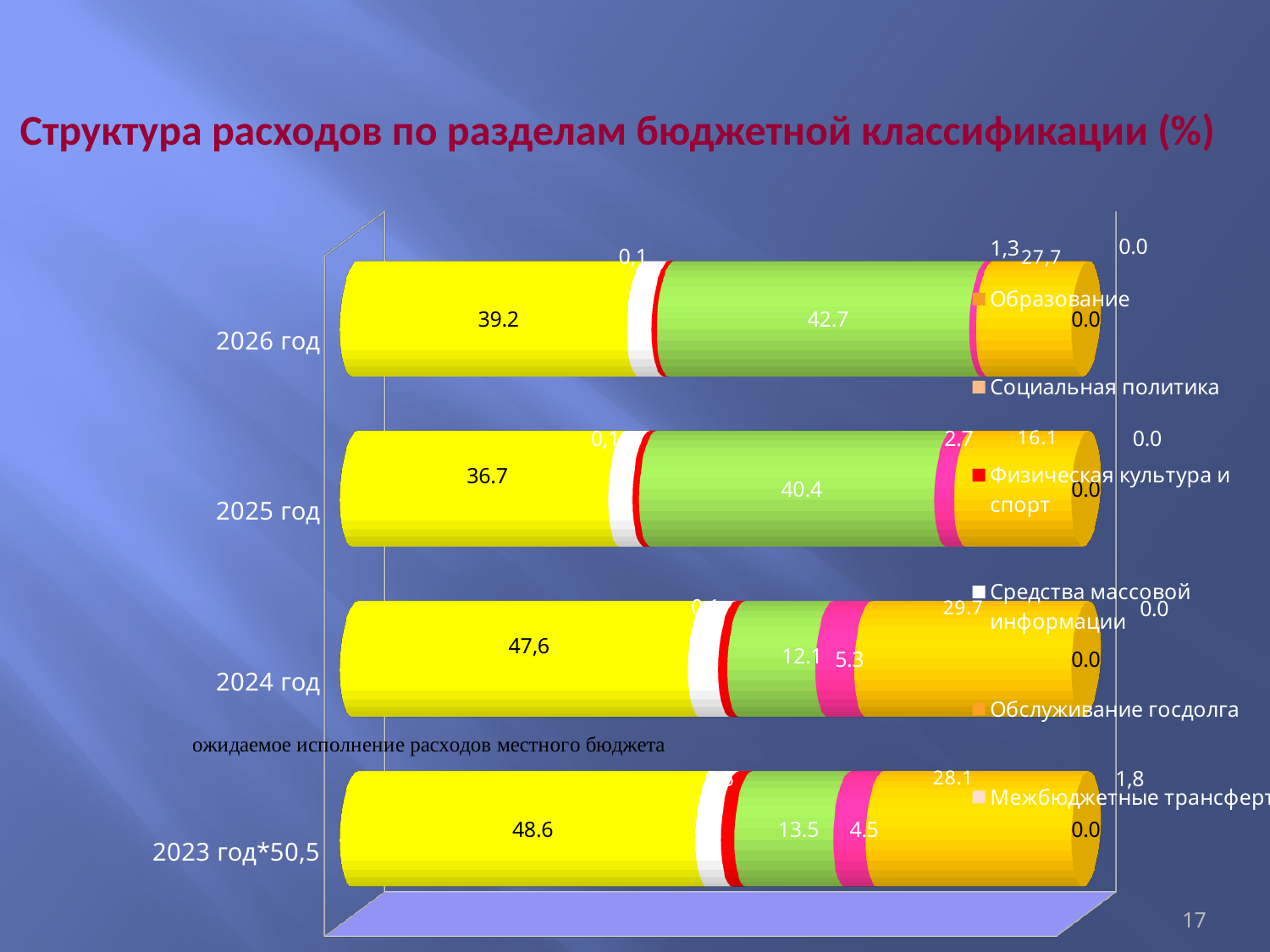
Which year has the largest yellow segment? 2023 год*50,5 What kind of chart is shown on the slide? Stacked bar chart What is the value of the pink segment for 2025 год? 2.7 What is the value of the yellow segment for 2026 год? 39.2 How many year categories are plotted on the chart? 4 What is the value of the green segment for 2024 год? 12.1 What is the difference between the yellow segment values for 2026 год and 2025 год? 2.5 What is the value of the yellow segment for 2023 год*50,5? 48.6 What is the value of the green segment for 2025 год? 40.4 What is the title of the chart on the slide? Структура расходов по разделам бюджетной классификации (%) Which year has the larger green segment, 2026 год or 2024 год? 2026 год